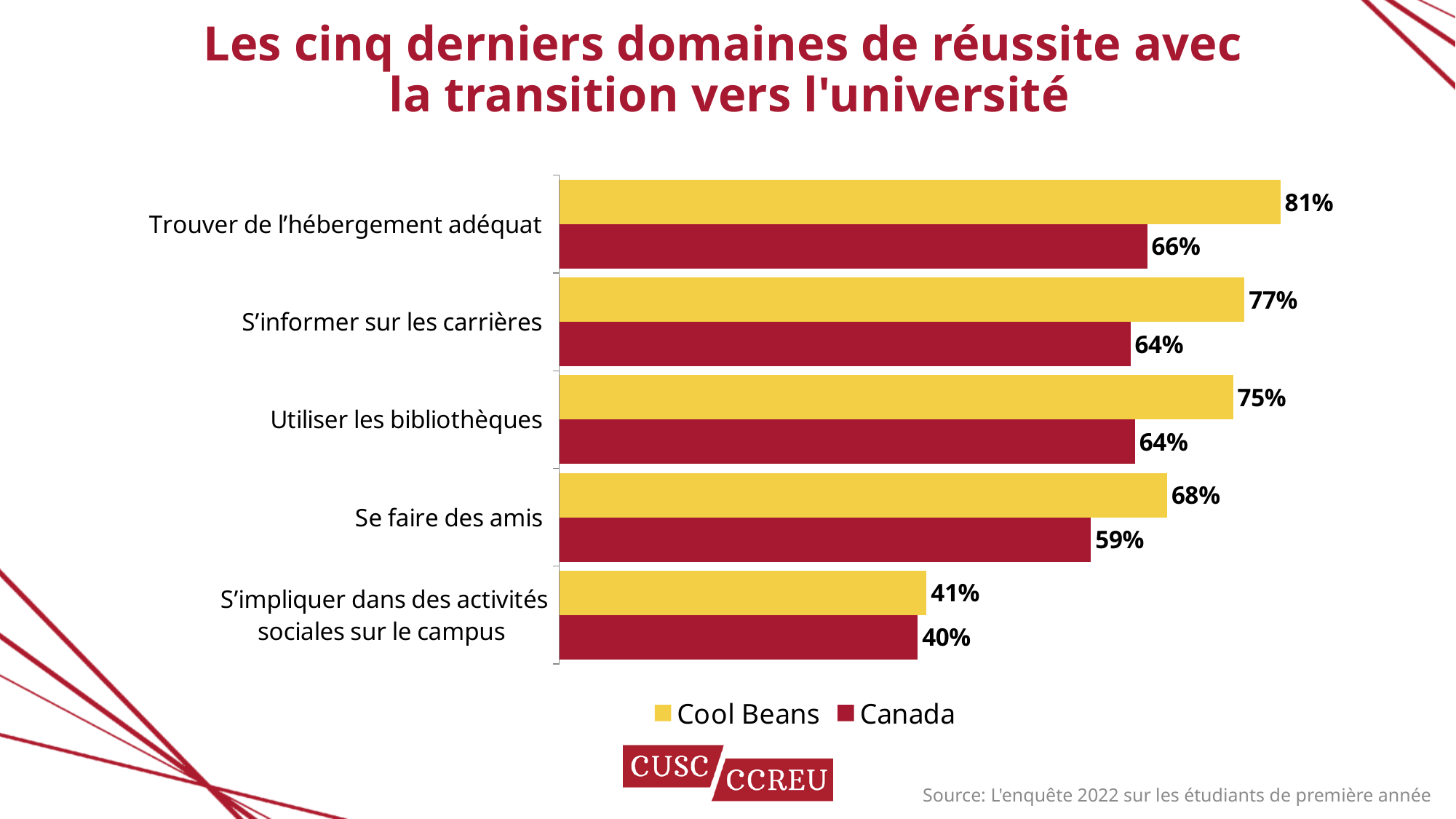
What is the difference between the Cool Beans and Canada values for "Trouver de l'hébergement adéquat"? 15% Which category has the lowest Canada value? S'impliquer dans des activités sociales sur le campus How many categories are shown in the chart? 5 Which is larger for "Utiliser les bibliothèques": the Cool Beans value or the Canada value? Cool Beans Which category has the highest Cool Beans value? Trouver de l'hébergement adéquat What kind of chart is shown on the slide? Bar chart What is the difference between the Cool Beans and Canada values for "S'impliquer dans des activités sociales sur le campus"? 1% What is the Cool Beans value for "Trouver de l'hébergement adéquat"? 81% What is the Canada value for "S'informer sur les carrières"? 64% Which colour represents the Canada series in the chart? Red How many series does the legend list? 2 What is the Canada value for "Se faire des amis"? 59%